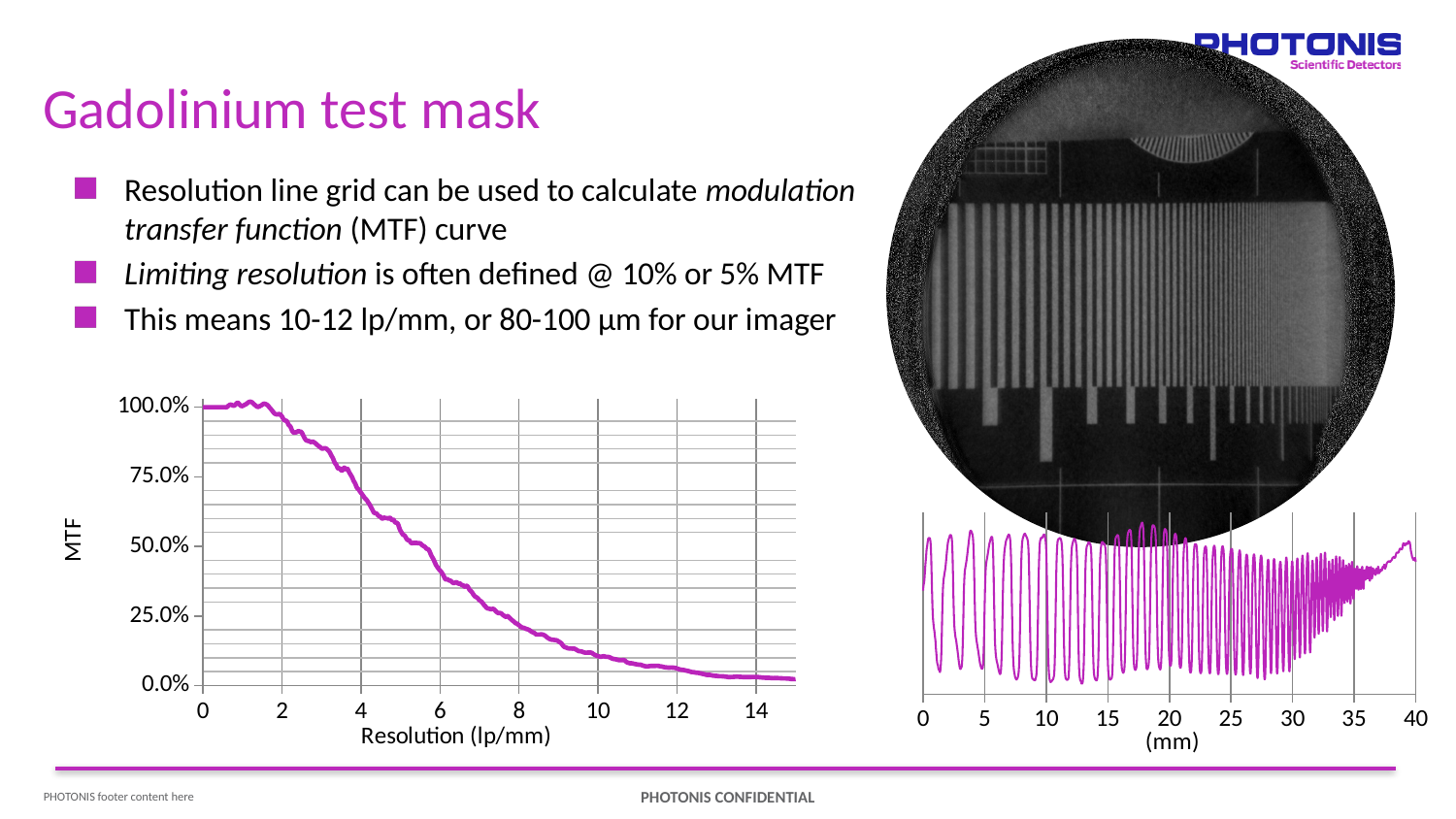
What is the x-axis label of the MTF chart? Resolution (lp/mm) How many charts are shown on the slide? 2 In the MTF chart, does the MTF value rise or fall as resolution increases along the x axis? fall What kind of chart is the chart on the right with the (mm) axis? line chart What kind of chart is the MTF chart on the left of the slide? line chart In the MTF chart, is the MTF value at 2 lp/mm greater or less than 75.0%? greater In the MTF chart, is the MTF value at 4 lp/mm greater or less than 50.0%? greater In the MTF chart, is the MTF value at 6 lp/mm greater or less than 50.0%? less In the MTF chart, is the MTF value at 4 lp/mm larger or smaller than the value at 8 lp/mm? larger What is the highest value shown on the x axis of the chart on the right with the (mm) axis? 40